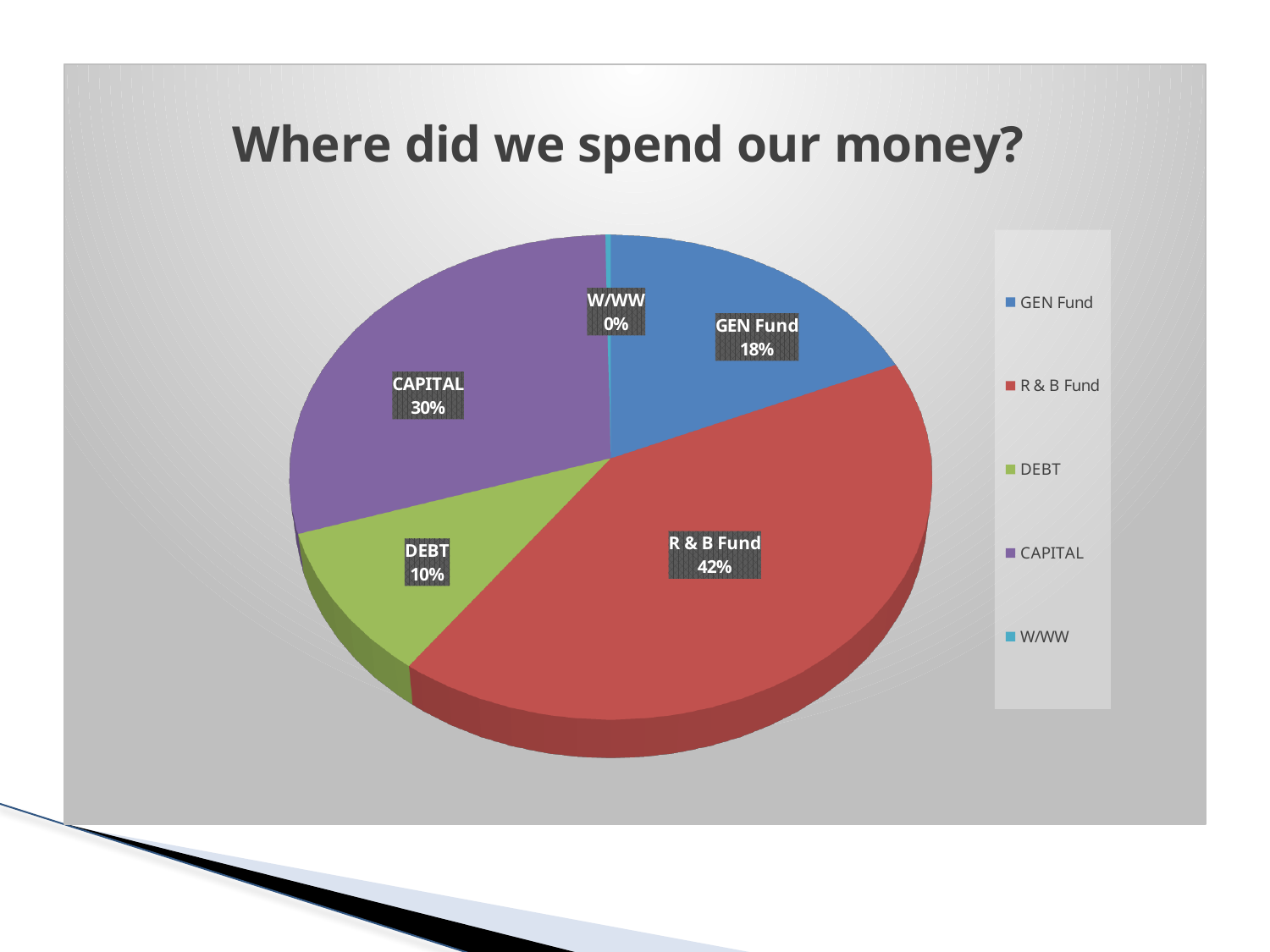
What percentage of the pie is CAPITAL? 30% How many categories are shown in the pie chart? 5 Which category has the largest share of spending? R & B Fund What is the title of the chart? Where did we spend our money? What share of spending went to the R & B Fund? 42% What is the difference in percentage points between the R & B Fund and CAPITAL shares? 12 Which is larger, the GEN Fund share or the DEBT share? GEN Fund What percentage is shown for W/WW? 0% Which category has the smallest share of spending? W/WW What share does the GEN Fund slice represent? 18% What type of chart is shown on the slide? Pie chart What percentage is shown for DEBT? 10%